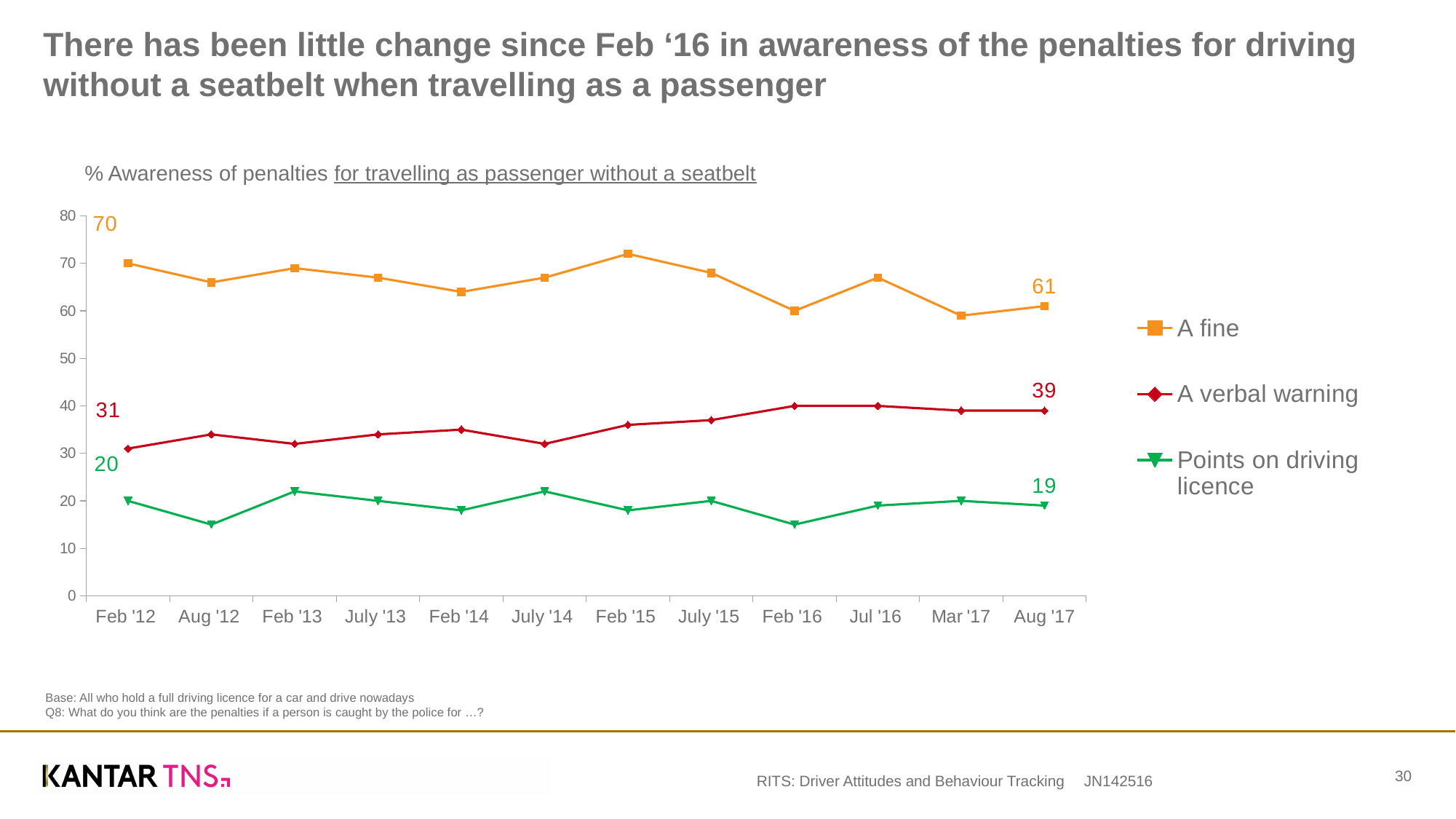
What is the value for A verbal warning at Aug '17? 39 What is the difference between the A verbal warning values at Feb '12 and Aug '17? 8 How many time points are shown on the x axis? 12 Which series has the lowest value at Aug '17? Points on driving licence By how much did the value for A fine fall between Feb '12 and Aug '17? 9 Is the value for A fine at Feb '15 greater or less than 70? greater Is the value for Points on driving licence at Aug '12 greater or less than 20? less What is the value for A fine at Aug '17? 61 How many series does the legend list? 3 What is the value for Points on driving licence at Feb '12? 20 What is the value for A fine at Feb '12? 70 At Aug '17, which is larger: A fine or A verbal warning? A fine